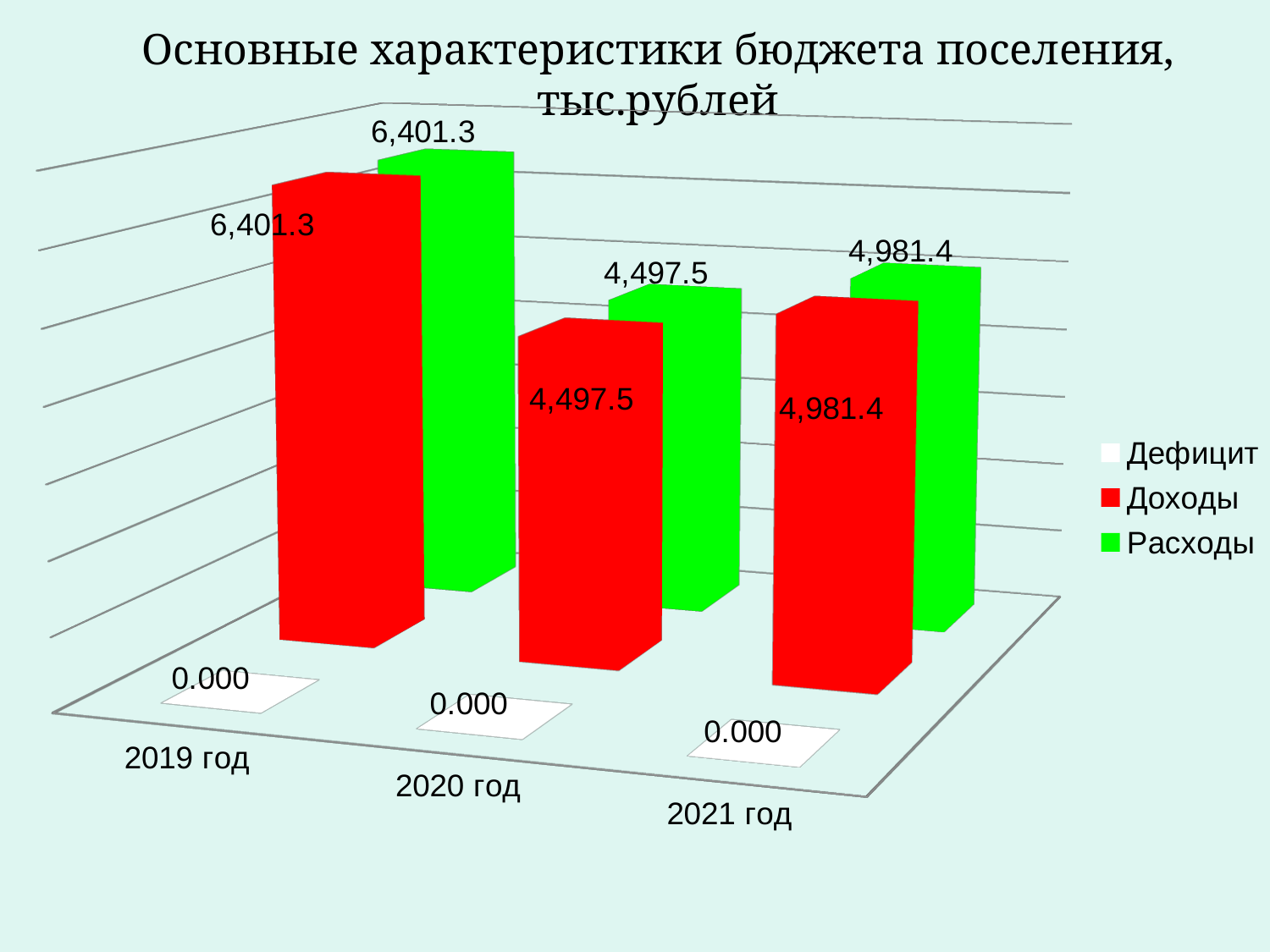
In which year is Доходы the highest? 2019 год How many years are shown on the x axis? 3 What is the value of Дефицит for 2020 год? 0.000 What is the difference between Доходы in 2019 год and Доходы in 2020 год? 1,903.8 What is the value of Расходы for 2020 год? 4,497.5 What is the difference between Расходы in 2021 год and Расходы in 2020 год? 483.9 Which is larger: Доходы in 2020 год or Доходы in 2021 год? Доходы in 2021 год What is the value of Доходы for 2021 год? 4,981.4 What kind of chart is shown on the slide? Bar chart What is the value of Доходы for 2019 год? 6,401.3 In which year is Расходы the lowest? 2020 год How many series does the legend list? 3